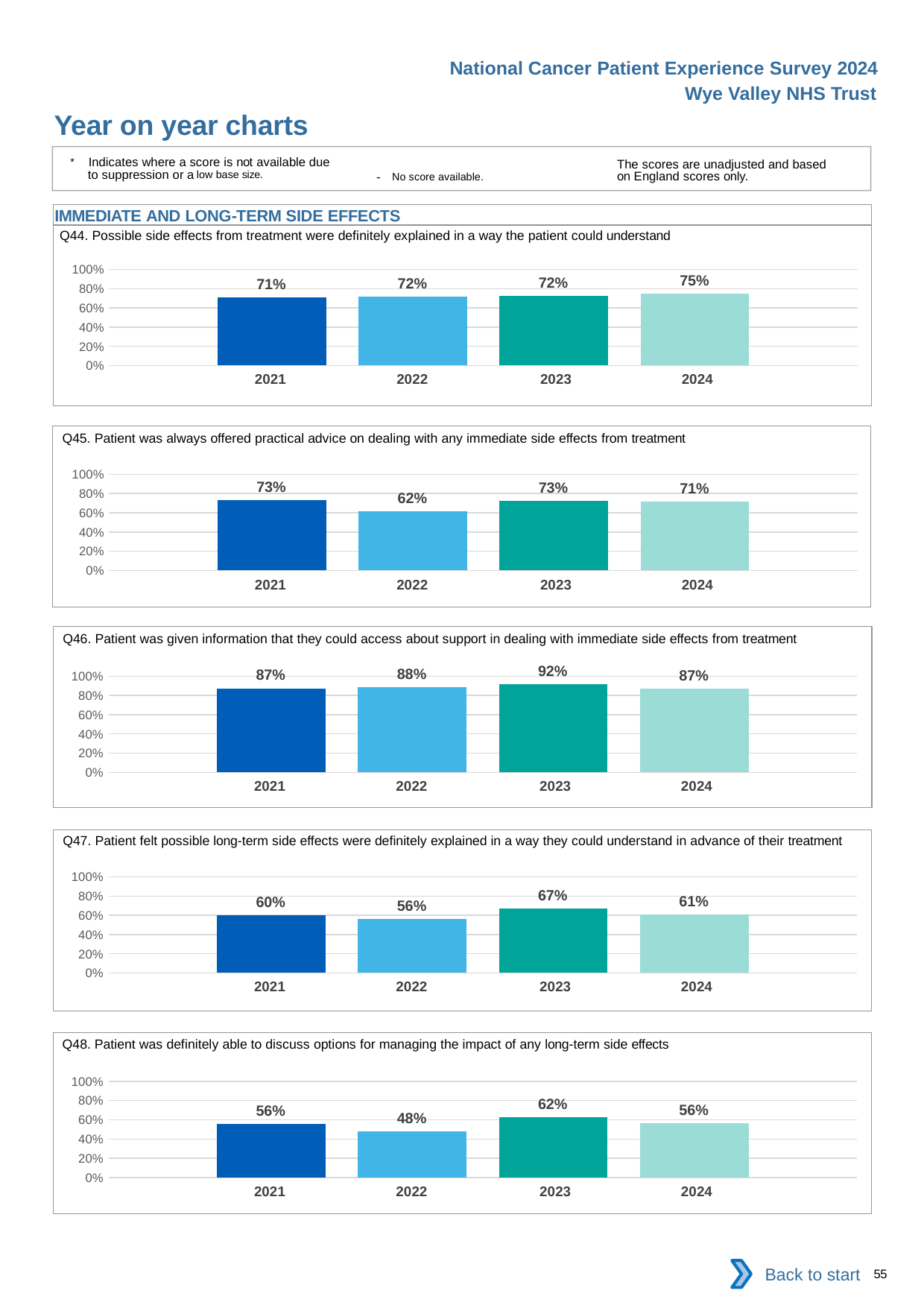
In the Q44 chart, how many years are plotted? 4 In the Q44 chart, what is the value for 2024? 75% In the Q47 chart, what is the difference between the 2023 and 2022 values? 11 percentage points In the Q46 chart, what is the value for 2021? 87% In the Q46 chart, which year has the highest value? 2023 In the Q45 chart, which year has the lowest value? 2022 How many charts are shown on the slide? 5 In the Q48 chart, what is the value for 2022? 48% In the Q44 chart, do the values rise or fall from 2021 to 2024? Rise In the Q47 chart, is the value for 2022 greater or less than 60%? less What kind of chart is the Q45 chart? Bar chart In the Q48 chart, which is larger, the value for 2021 or the value for 2023? 2023